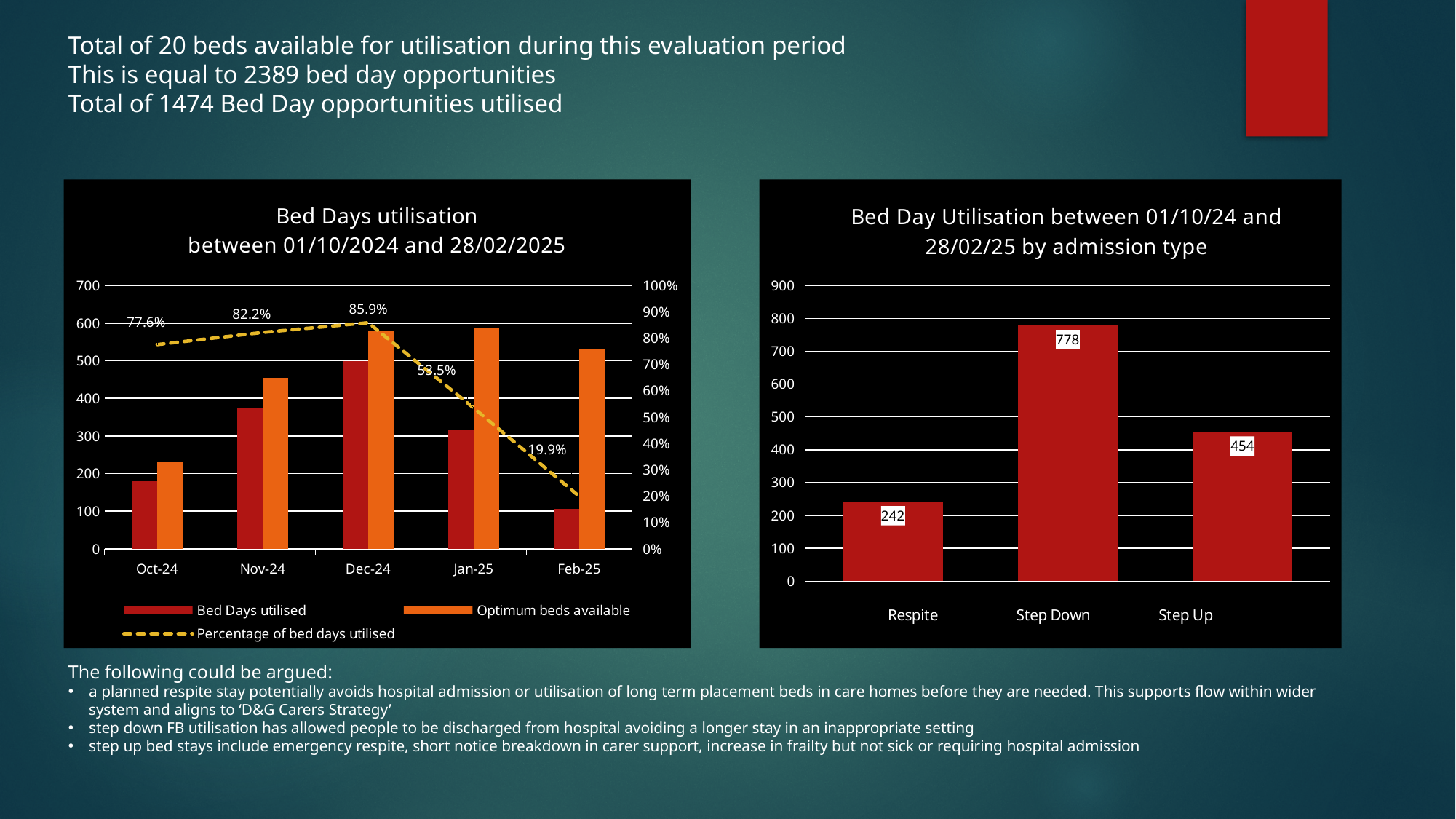
In the 'Bed Day Utilisation ... by admission type' chart, which admission type has the highest value? Step Down In the 'Bed Day Utilisation ... by admission type' chart, what is the difference between Step Down and Step Up? 324 In the 'Bed Days utilisation between 01/10/2024 and 28/02/2025' chart, which month has the highest percentage of bed days utilised? Dec-24 In the 'Bed Day Utilisation ... by admission type' chart, which admission type has the lowest value? Respite In the 'Bed Days utilisation between 01/10/2024 and 28/02/2025' chart, what is the percentage of bed days utilised for Dec-24? 85.9% In the 'Bed Days utilisation between 01/10/2024 and 28/02/2025' chart, how many series does the legend list? 3 In the 'Bed Day Utilisation ... by admission type' chart, how many admission types are shown? 3 In the 'Bed Day Utilisation ... by admission type' chart, what is the value for Respite? 242 In the 'Bed Days utilisation between 01/10/2024 and 28/02/2025' chart, does the percentage of bed days utilised rise or fall from Dec-24 to Feb-25? fall In the 'Bed Days utilisation between 01/10/2024 and 28/02/2025' chart, what is the percentage of bed days utilised for Feb-25? 19.9% In the 'Bed Day Utilisation ... by admission type' chart, what is the value for Step Down? 778 In the 'Bed Days utilisation between 01/10/2024 and 28/02/2025' chart, is the value of Bed Days utilised for Nov-24 greater or less than 300? greater